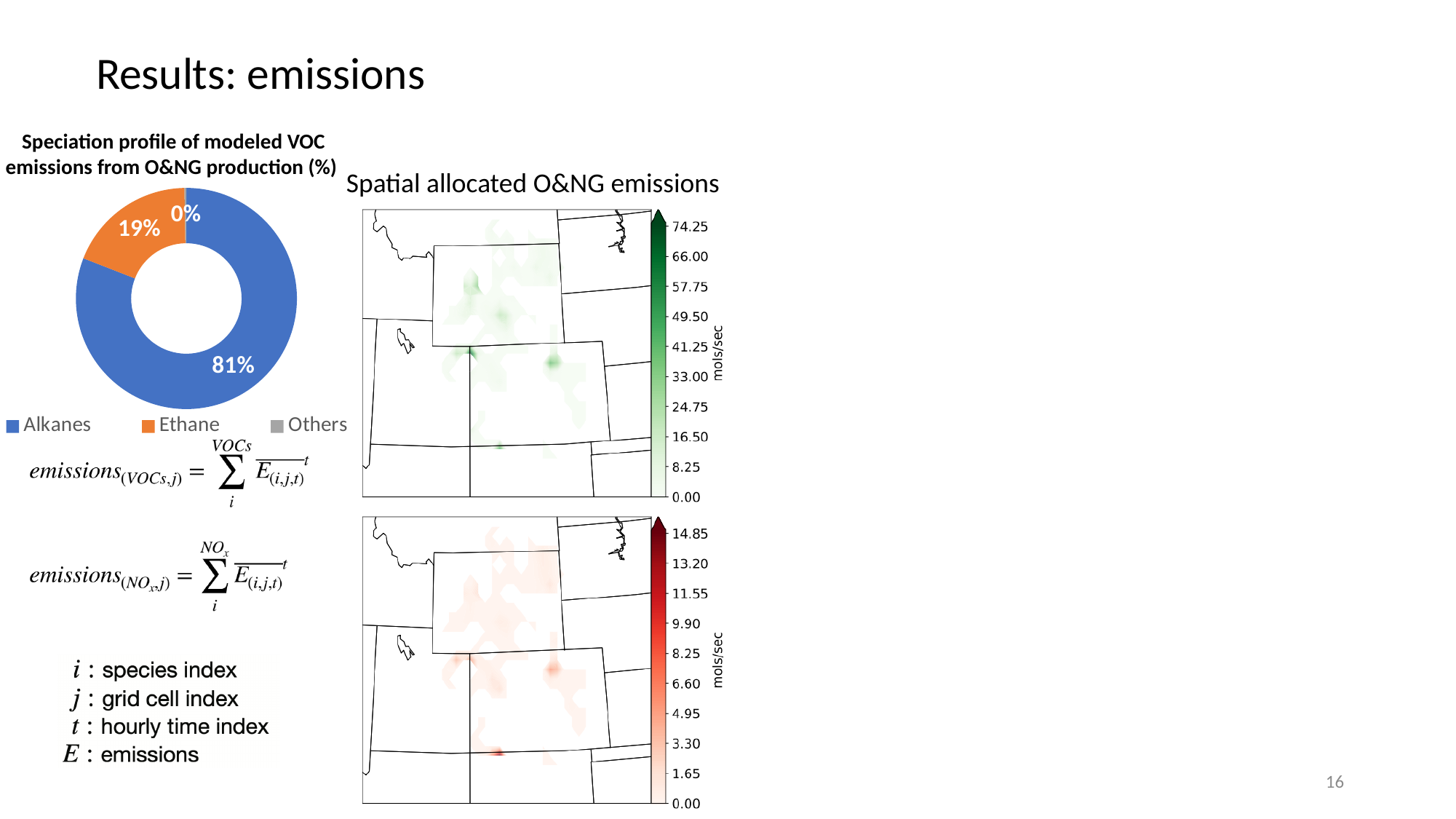
In the lower 'Spatial allocated O&NG emissions' map, what unit is shown on the colour bar? mols/sec In the 'Speciation profile of modeled VOC emissions from O&NG production (%)' chart, what share does Others have? 0% In the 'Speciation profile of modeled VOC emissions from O&NG production (%)' chart, which category has the largest share? Alkanes In the 'Speciation profile of modeled VOC emissions from O&NG production (%)' chart, which category has the smallest share? Others In the 'Speciation profile of modeled VOC emissions from O&NG production (%)' chart, what is the difference in percentage points between Alkanes and Ethane? 62 In the upper 'Spatial allocated O&NG emissions' map, what is the maximum value shown on the colour bar? 74.25 How many categories does the legend of the 'Speciation profile of modeled VOC emissions from O&NG production (%)' chart list? 3 In the 'Speciation profile of modeled VOC emissions from O&NG production (%)' chart, what colour represents Ethane? Orange In the 'Speciation profile of modeled VOC emissions from O&NG production (%)' chart, what share do Alkanes have? 81% In the 'Speciation profile of modeled VOC emissions from O&NG production (%)' chart, which is larger, Ethane or Others? Ethane What kind of chart is the 'Speciation profile of modeled VOC emissions from O&NG production (%)' chart? Pie (donut) chart In the 'Speciation profile of modeled VOC emissions from O&NG production (%)' chart, what share does Ethane have? 19%